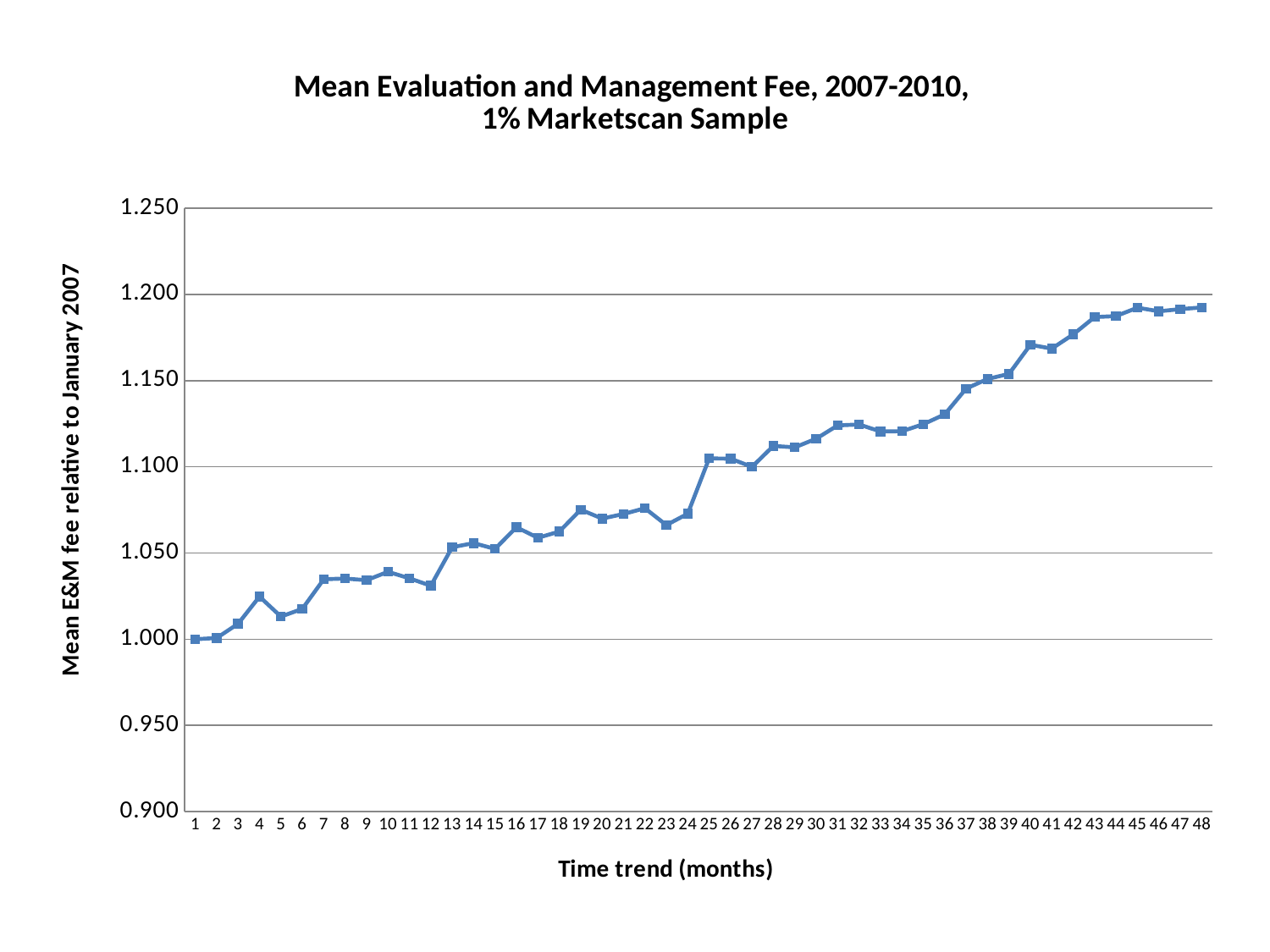
Do the values generally rise or fall as the months increase along the x axis? rise Is the value for month 48 greater or less than 1.150? greater What is the title of the chart? Mean Evaluation and Management Fee, 2007-2010, 1% Marketscan Sample What is the label of the x axis? Time trend (months) Which has the larger value, month 1 or month 48? month 48 What is the value for month 1? 1.000 Is the value for month 36 greater or less than 1.150? less Which has the larger value, month 25 or month 24? month 25 Is the value for month 20 greater or less than 1.100? less What kind of chart is shown on the slide? line chart How many monthly data points are plotted on the chart? 48